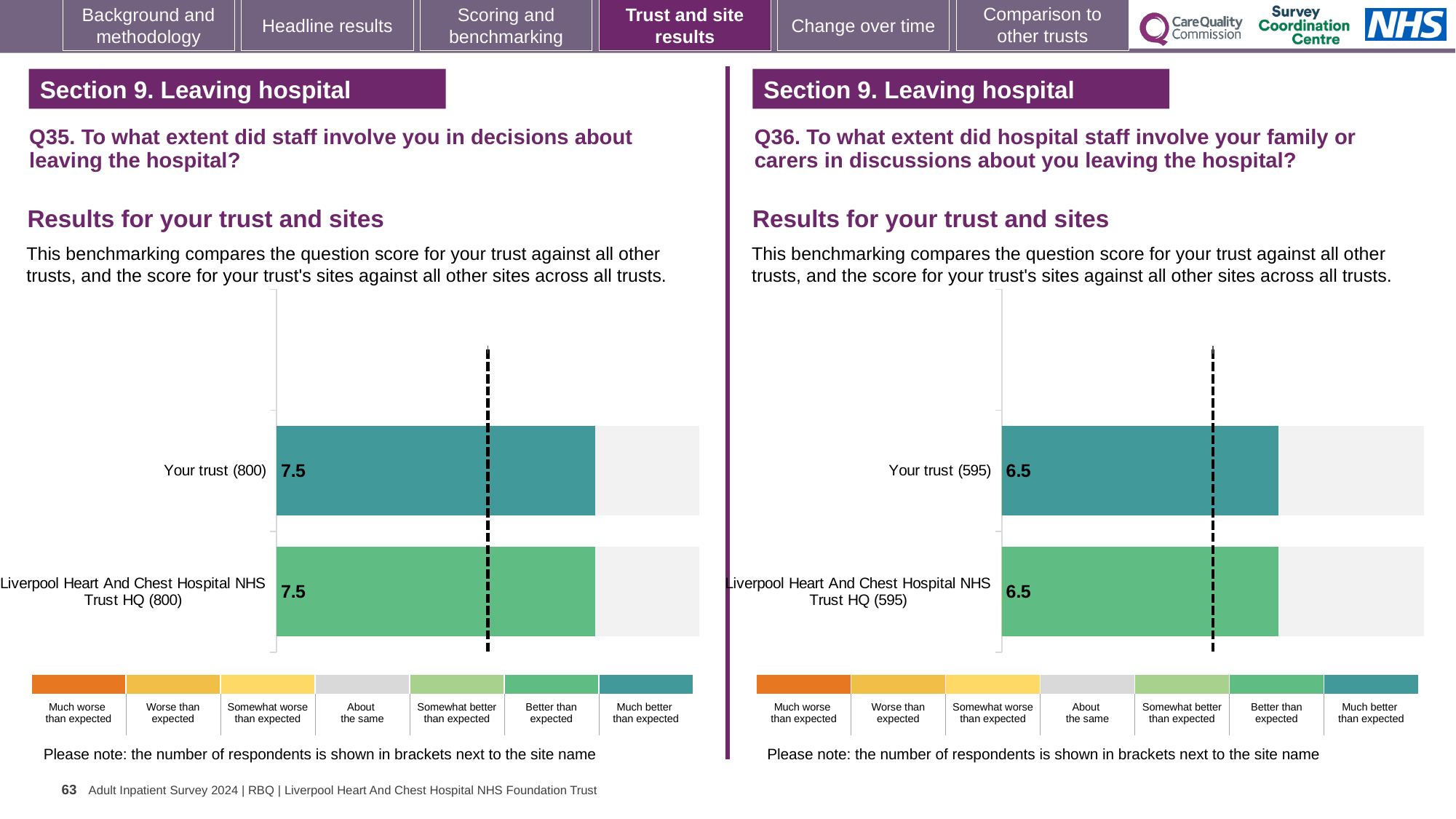
In the Q35 chart on the left, what is the score for Liverpool Heart And Chest Hospital NHS Trust HQ? 7.5 What type of chart is used for the Q35 results on the left? Bar chart In the Q36 chart on the right, what is the score for Your trust? 6.5 In the Q36 chart on the right, what is the score for Liverpool Heart And Chest Hospital NHS Trust HQ? 6.5 In the Q36 chart on the right, what is the difference between the score for Your trust and the score for Liverpool Heart And Chest Hospital NHS Trust HQ? 0 In the Q35 chart on the left, what is the difference between the score for Your trust and the score for Liverpool Heart And Chest Hospital NHS Trust HQ? 0 In the Q35 chart on the left, how many respondents are shown in brackets next to Your trust? 800 In the Q35 chart on the left, what is the score for Your trust? 7.5 In the Q36 chart on the right, what colour is the bar for Your trust? Teal How many bars are plotted in the Q36 chart on the right? 2 How many bars are plotted in the Q35 chart on the left? 2 In the Q36 chart on the right, how many respondents are shown in brackets next to Liverpool Heart And Chest Hospital NHS Trust HQ? 595